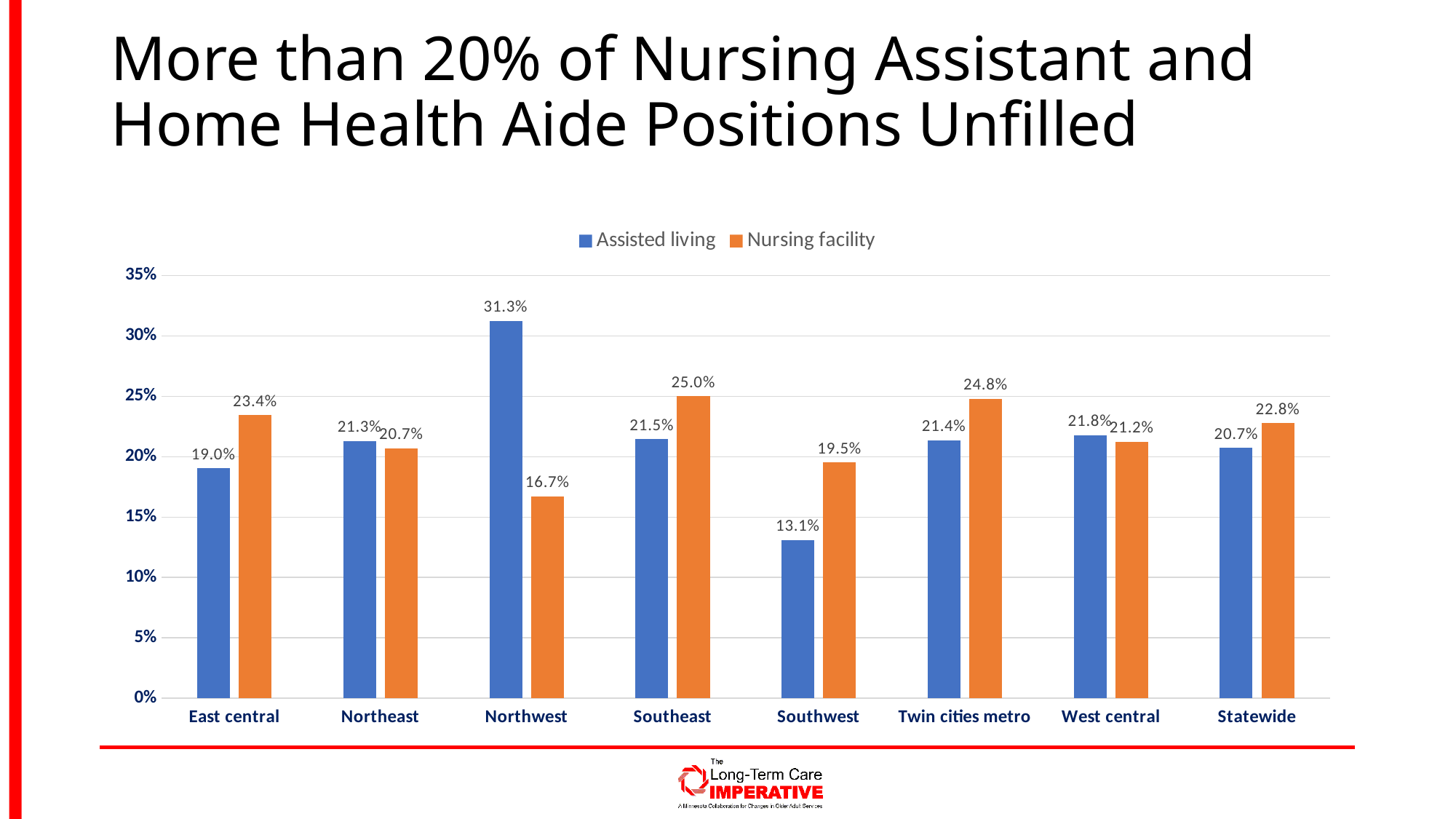
Which region has the lowest Nursing facility value? Northwest What is the Nursing facility value for Southeast? 25.0% Which colour represents the Nursing facility series? Orange What kind of chart is shown on the slide? Bar chart How many regions (categories) are shown on the x axis? 8 How many series does the legend list? 2 For Southwest, which is larger: Assisted living or Nursing facility? Nursing facility What is the difference between the Assisted living and Nursing facility values for Northwest? 14.6% What is the Assisted living value for Northwest? 31.3% What is the Assisted living value for Statewide? 20.7% Which region has the lowest Assisted living value? Southwest Which region has the highest Assisted living value? Northwest